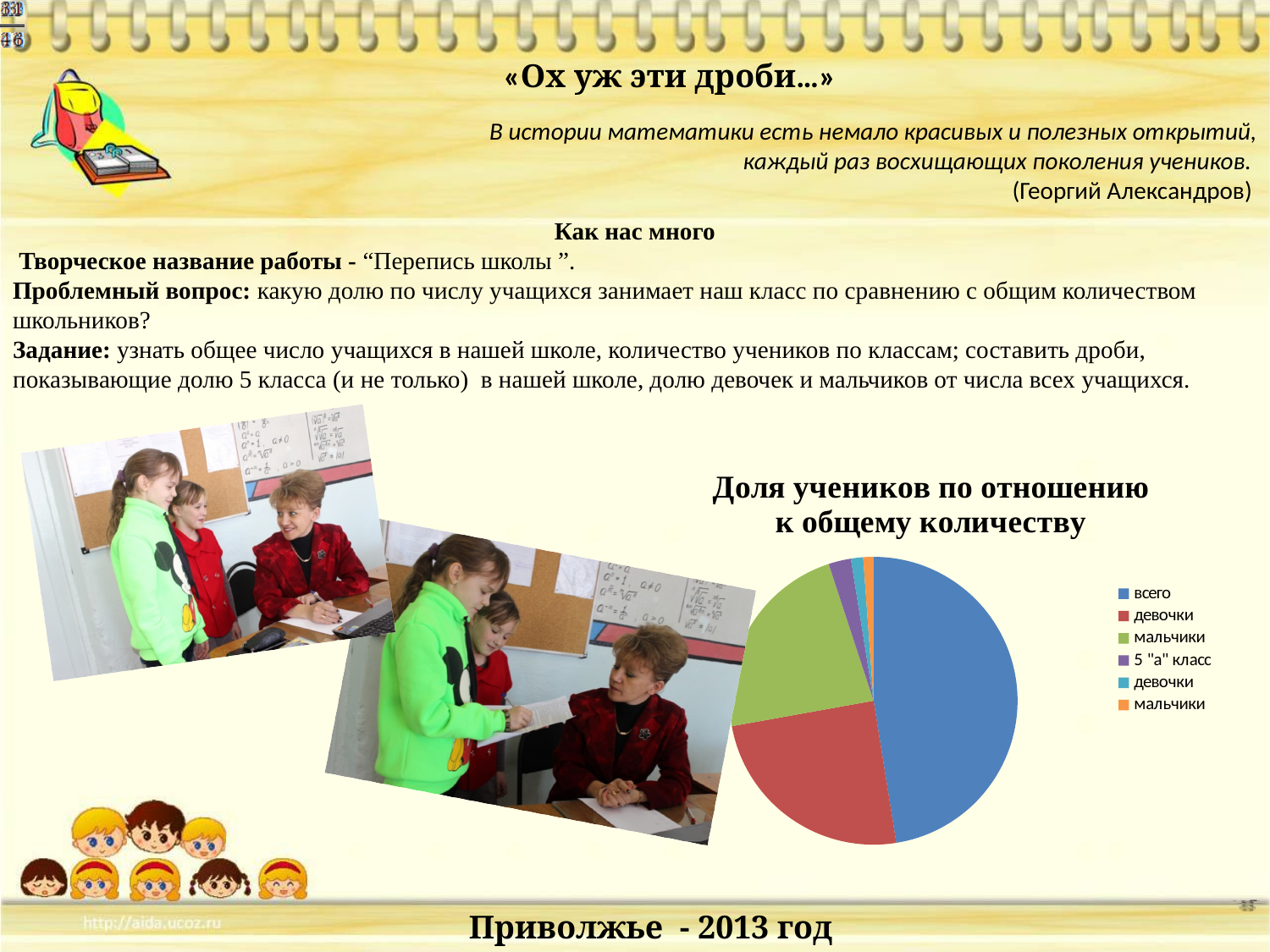
What kind of chart is shown on the slide? pie chart What colour is the всего slice in the pie chart? blue Which category has the largest slice in the pie chart? всего How many slices does the pie chart have? 6 What is the title of the pie chart? Доля учеников по отношению к общему количеству Which slice is larger: the red девочки slice or the green мальчики slice? девочки (red) Which slice is larger: всего or 5 "а" класс? всего How many entries does the legend of the pie chart list? 6